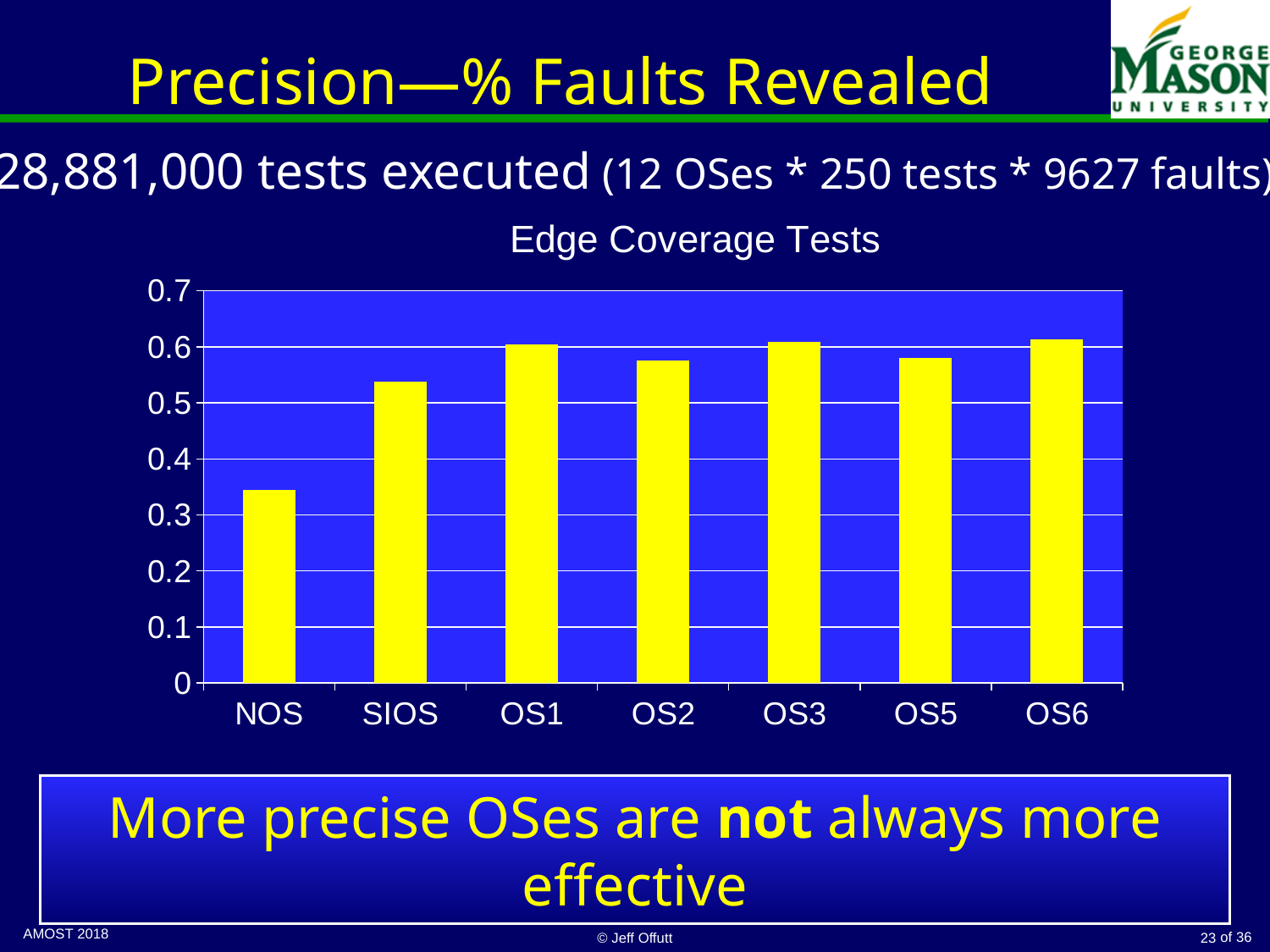
Is the value for OS5 greater or less than 0.5? greater What is the title of the chart? Edge Coverage Tests Is the value for SIOS greater or less than 0.5? greater Is the value for OS2 greater or less than 0.6? less How many categories are shown on the x axis of the chart? 7 Which is larger, the value for OS1 or the value for OS2? OS1 Which category has the lowest value in the chart? NOS What kind of chart is shown on the slide? bar chart What colour are the bars in the chart? yellow Which is larger, the value for NOS or the value for SIOS? SIOS